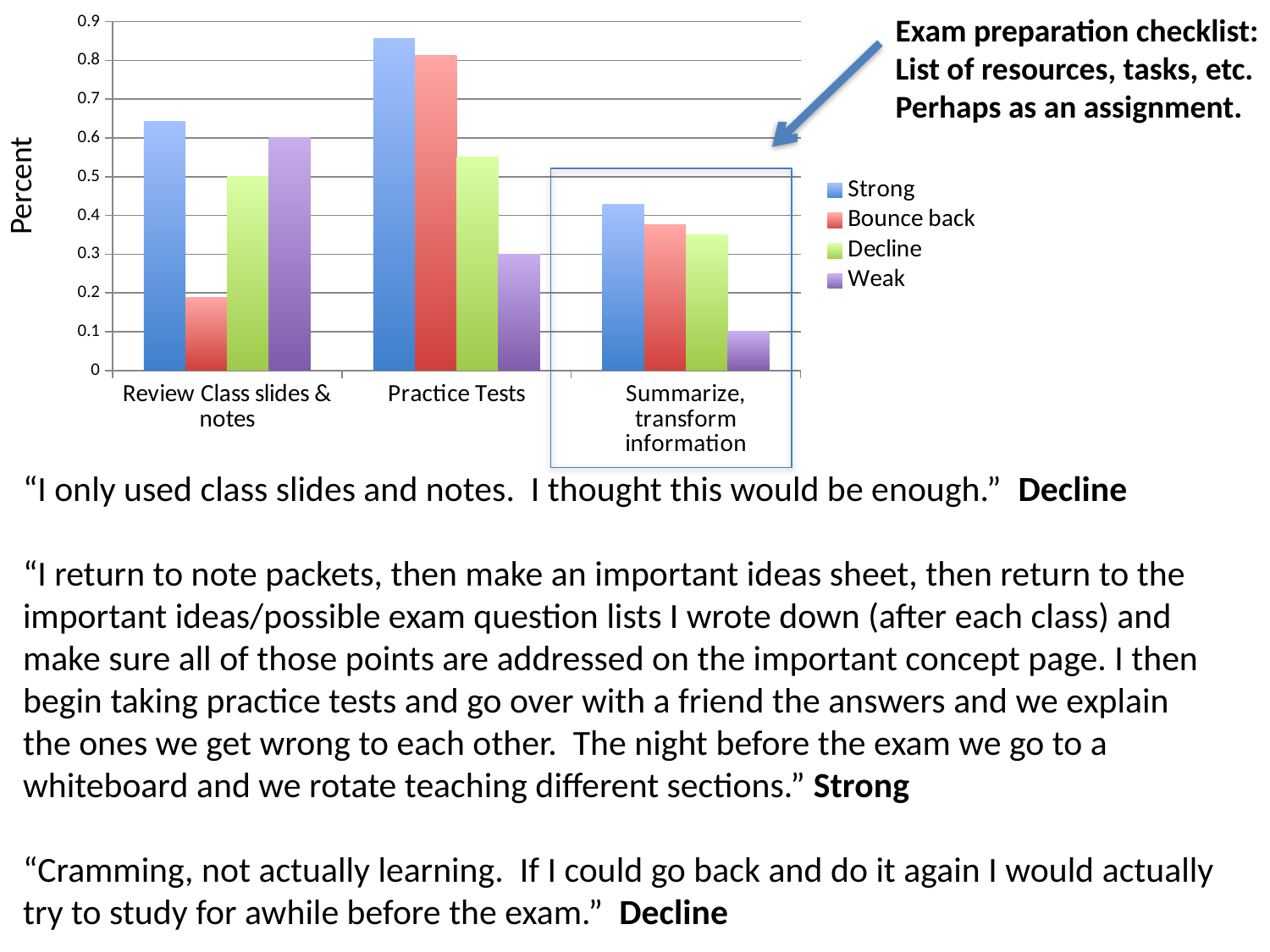
What kind of chart is shown on the slide? bar chart For Practice Tests, which is larger: Decline or Weak? Decline For Review Class slides & notes, which is larger: Strong or Bounce back? Strong Which category has the highest value for the Strong series? Practice Tests Is the Strong value for Practice Tests greater or less than 0.8? greater What is the label on the y axis? Percent How many series does the legend list? 4 Is the Bounce back value for Review Class slides & notes greater or less than 0.3? less Which category has the lowest value for the Weak series? Summarize, transform information How many categories are shown on the x axis? 3 Is the Weak value for Summarize, transform information greater or less than 0.2? less Within the Practice Tests category, which series has the lowest value? Weak